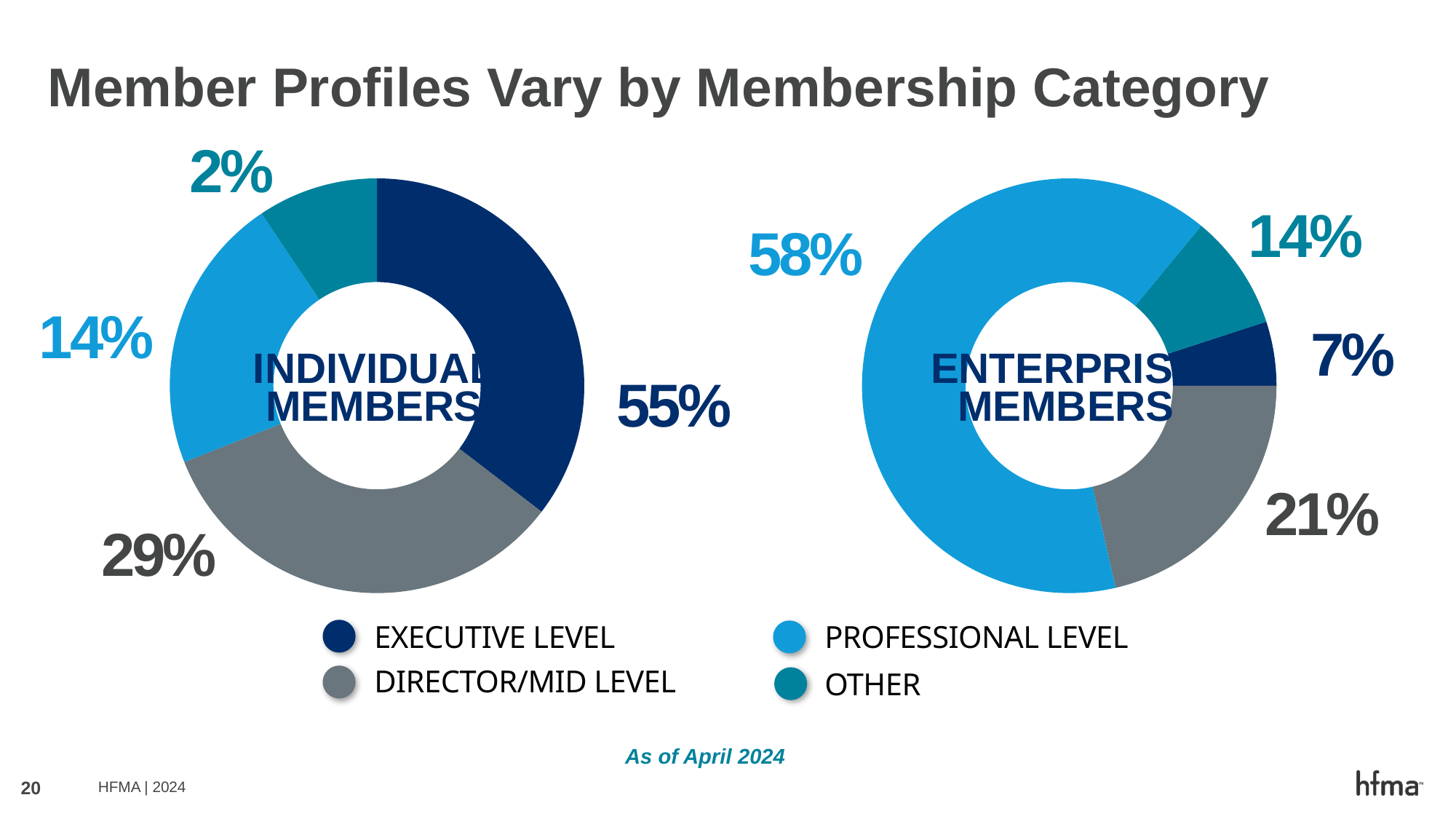
Which chart has the larger Professional Level share, Individual Members or Enterprise Members? Enterprise Members In the Individual Members chart, what share of members fall under Other? 2% In the Individual Members chart, which category has the largest share? Executive Level In the Enterprise Members chart, what share of members are Professional Level? 58% What type of chart is used for the Enterprise Members data? Pie (donut) chart How many categories does the legend list? 4 In the Enterprise Members chart, which category has the smallest share? Executive Level In the Individual Members chart, what is the difference between the Executive Level share and the Director/Mid Level share? 26 percentage points In the Enterprise Members chart, what share of members are Executive Level? 7% In the Individual Members chart, what share of members are Director/Mid Level? 29% In the Enterprise Members chart, what share of members are Director/Mid Level? 21% In the Individual Members chart, what share of members are Executive Level? 55%